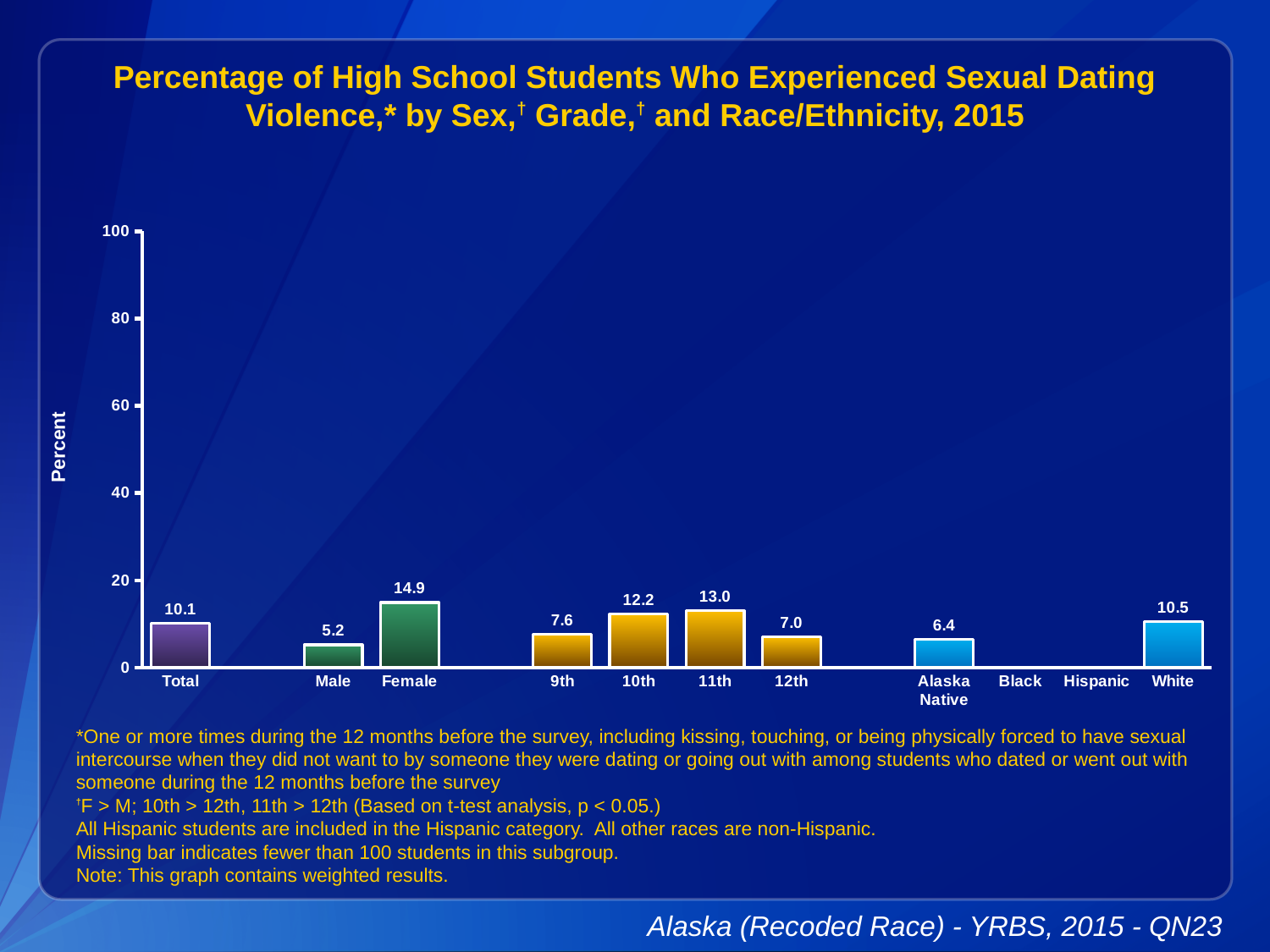
What is the value for Alaska Native? 6.4 Which category has the lowest value among the bars shown? Male Which category has the highest value? Female How many bars are plotted on the chart? 9 Which is larger, the value for 10th grade or 12th grade? 10th Which categories have no bar shown? Black and Hispanic What is the value for Male? 5.2 What is the difference between the Female and Male values? 9.7 What kind of chart is shown? bar chart What is the value for Female? 14.9 Is the value for Total greater or less than 20? less What is the value for 11th grade? 13.0